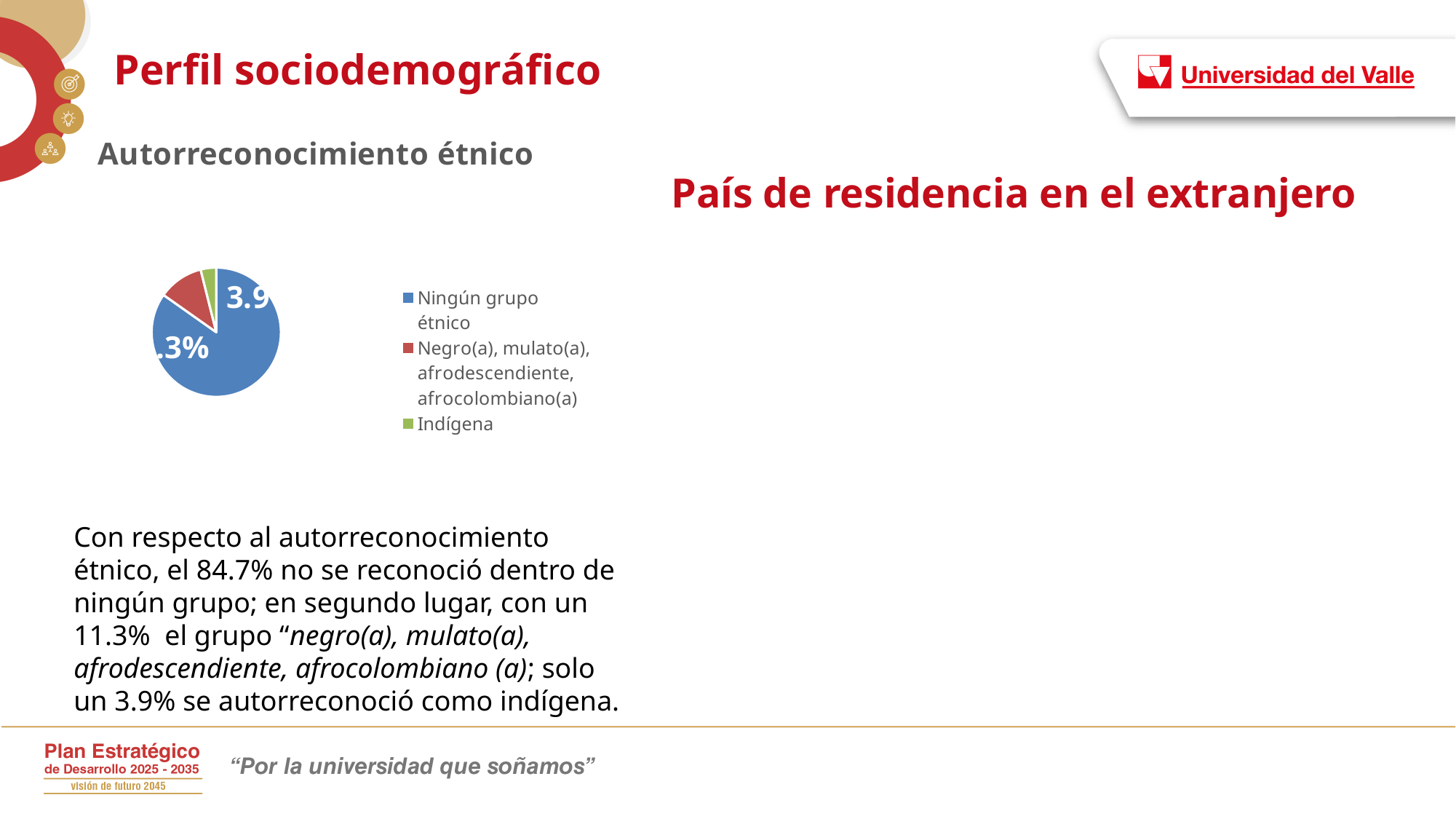
What percentage of the pie corresponds to Negro(a), mulato(a), afrodescendiente, afrocolombiano(a)? 11.3% What colour is the slice for Indígena in the pie chart? green How many slices does the pie chart have? 3 What percentage of the pie corresponds to Indígena? 3.9% How many entries does the legend of the pie chart list? 3 What colour is the slice for Ningún grupo étnico in the pie chart? blue What percentage of the pie corresponds to Ningún grupo étnico? 84.7% Which slice is larger: Negro(a), mulato(a), afrodescendiente, afrocolombiano(a) or Indígena? Negro(a), mulato(a), afrodescendiente, afrocolombiano(a) What kind of chart is shown on the slide? pie chart Which category has the largest slice in the pie chart? Ningún grupo étnico Which category has the smallest slice in the pie chart? Indígena What is the difference between the share for Negro(a), mulato(a), afrodescendiente, afrocolombiano(a) and the share for Indígena? 7.4%